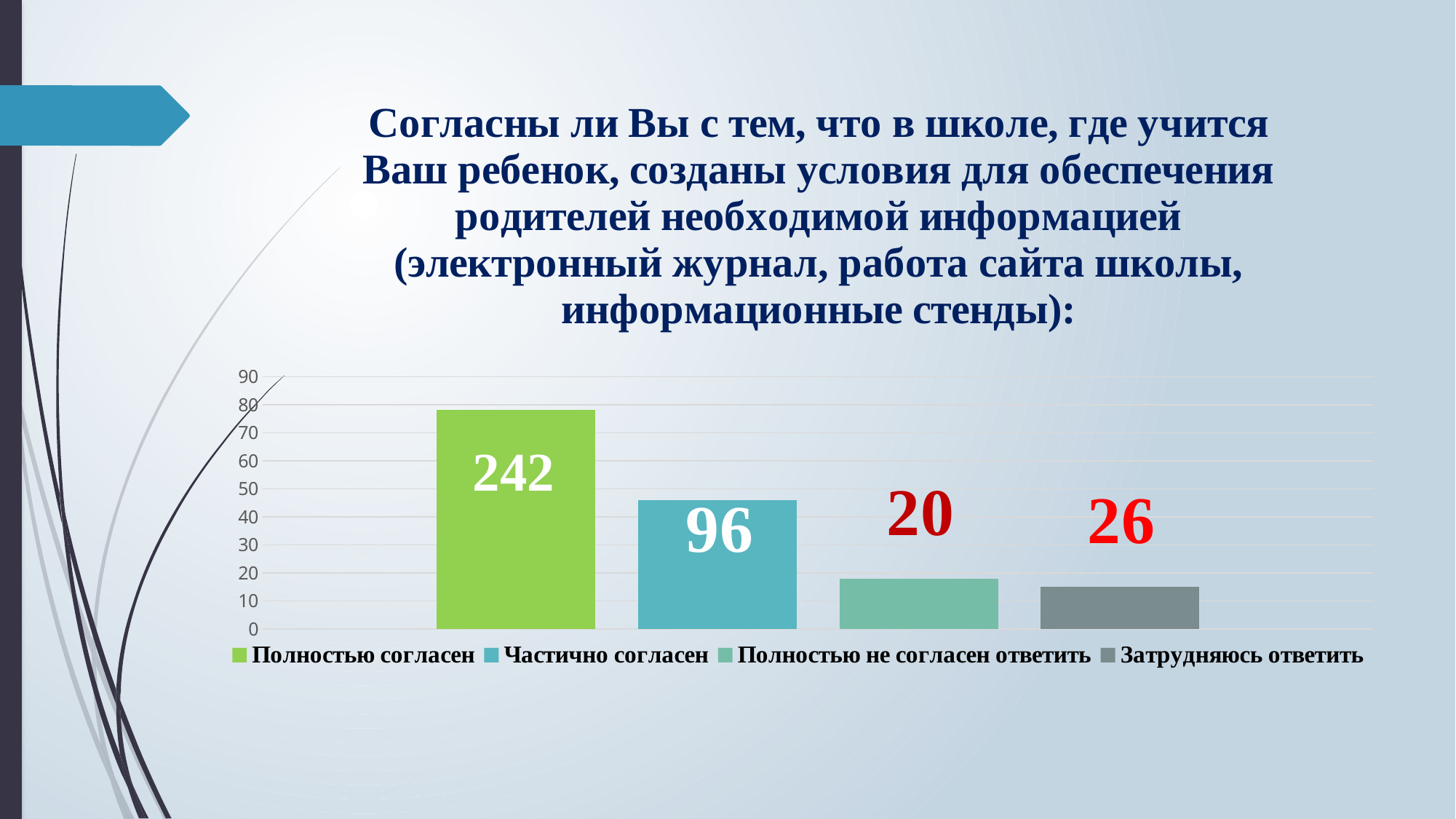
Which is larger, the value for "Полностью согласен" or the value for "Частично согласен"? Полностью согласен What value is shown for "Затрудняюсь ответить"? 26 Which category has the highest value? Полностью согласен How many entries does the legend list? 4 What colour is the bar for "Частично согласен"? blue How many categories are shown in the chart? 4 What value is shown for "Полностью согласен"? 242 Is the bar for "Полностью согласен" greater or less than 60 on the axis? greater What value is shown for "Частично согласен"? 96 What value is shown for "Полностью не согласен ответить"? 20 What kind of chart is shown on the slide? bar chart What is the difference between the values for "Полностью согласен" and "Частично согласен"? 146